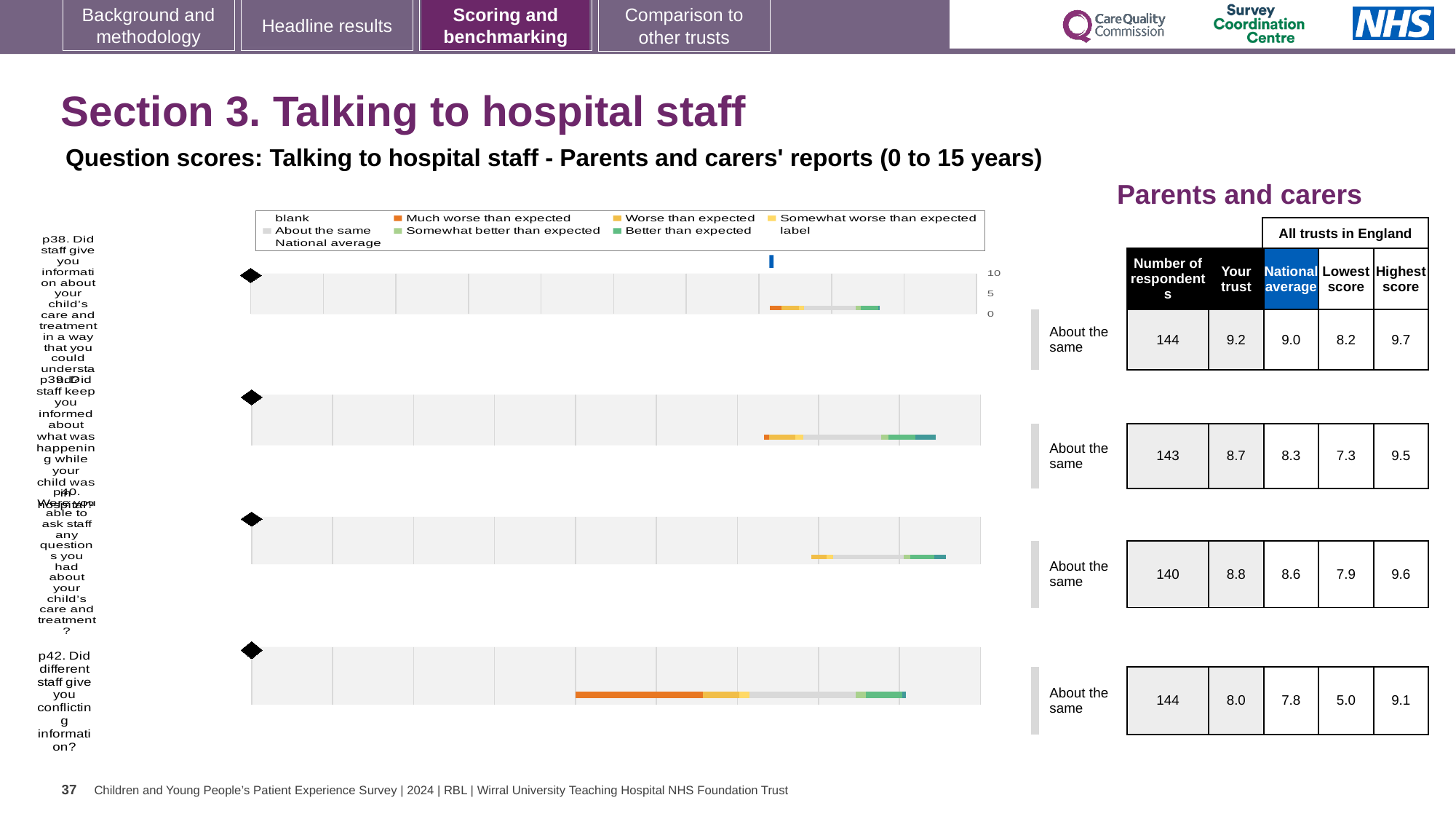
In the legend above the charts, what colour represents 'Much worse than expected'? orange Which of the four questions has the lowest 'Your trust' score? p42 For the p39 chart (staff keeping you informed while your child was in hospital), what is the national average score shown in the table? 8.3 How many question charts (p38, p39, p40, p42) are shown on the slide? 4 For the p40 chart (being able to ask staff questions), how many respondents are listed? 140 For the p38 chart, which is larger: the 'Your trust' score or the national average? Your trust Which of the four questions has the highest 'Your trust' score? p38 For the p38 chart (staff giving information about your child's care and treatment), what is the 'Your trust' score shown in the table? 9.2 For the p42 chart (different staff giving conflicting information), what is the lowest score among all trusts in England? 5.0 What is the title shown above the table to the right of the charts? Parents and carers What kind of chart is used to show the question scores on this slide? bar chart For the p42 chart, what is the difference between the highest score and the lowest score among all trusts in England? 4.1